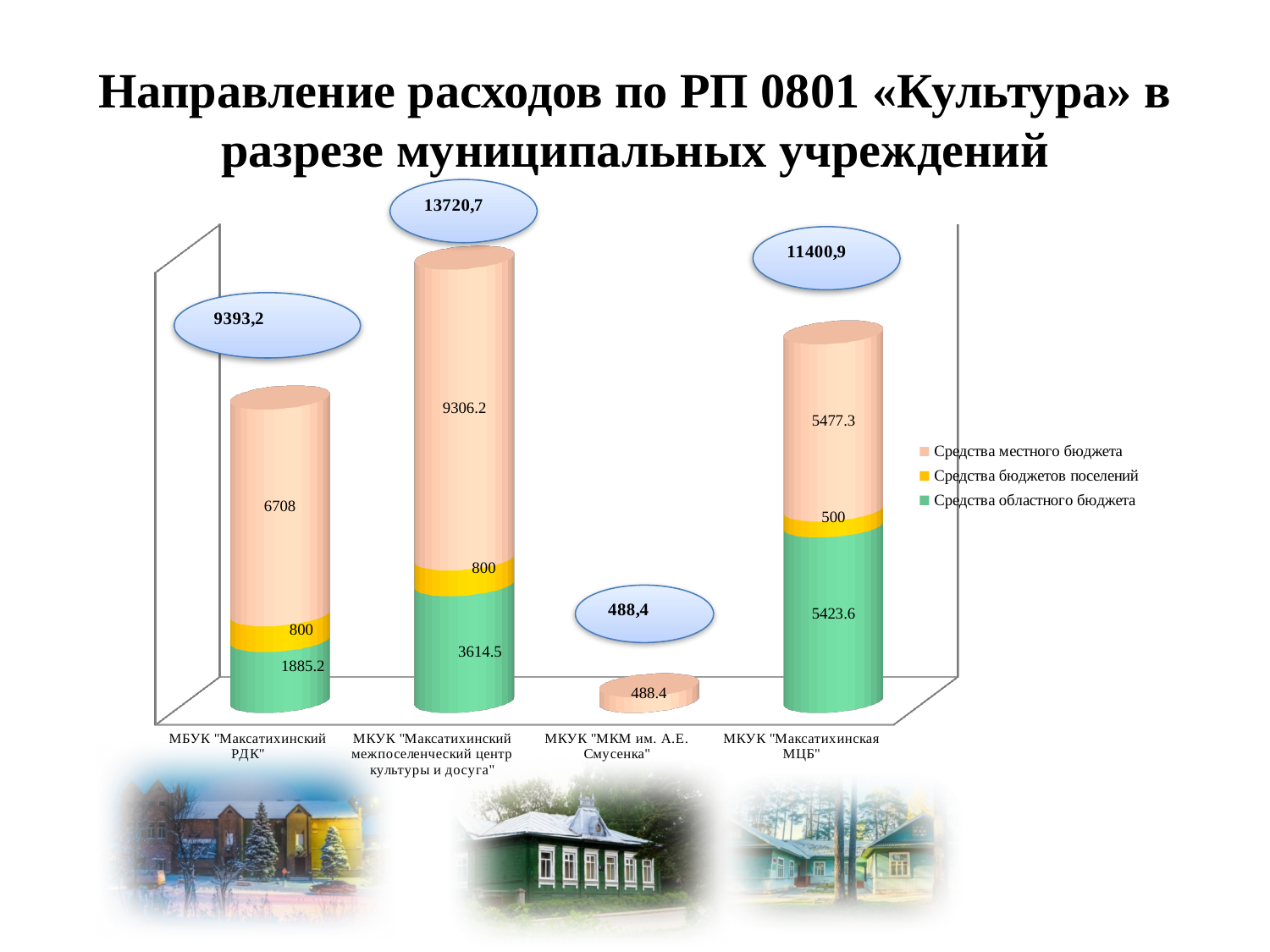
What is the difference between the Средства местного бюджета values for МКУК "Максатихинский межпоселенческий центр культуры и досуга" and МКУК "Максатихинская МЦБ"? 3828.9 What is the total shown in the callout above the bar for МКУК "Максатихинский межпоселенческий центр культуры и досуга"? 13720,7 How many series does the legend list? 3 Which legend entry is shown in green? Средства областного бюджета What is the value of Средства местного бюджета for МБУК "Максатихинский РДК"? 6708 What is the value of Средства областного бюджета for МКУК "Максатихинский межпоселенческий центр культуры и досуга"? 3614.5 What type of chart is shown on the slide? Stacked bar chart Which institution has the lowest total expenditure? МКУК "МКМ им. А.Е. Смусенка" What is the value of Средства бюджетов поселений for МКУК "Максатихинская МЦБ"? 500 Which institution has the highest total expenditure? МКУК "Максатихинский межпоселенческий центр культуры и досуга" How many institutions (categories) are shown on the x axis? 4 Which is larger: Средства областного бюджета for МКУК "Максатихинская МЦБ" or for МБУК "Максатихинский РДК"? МКУК "Максатихинская МЦБ"